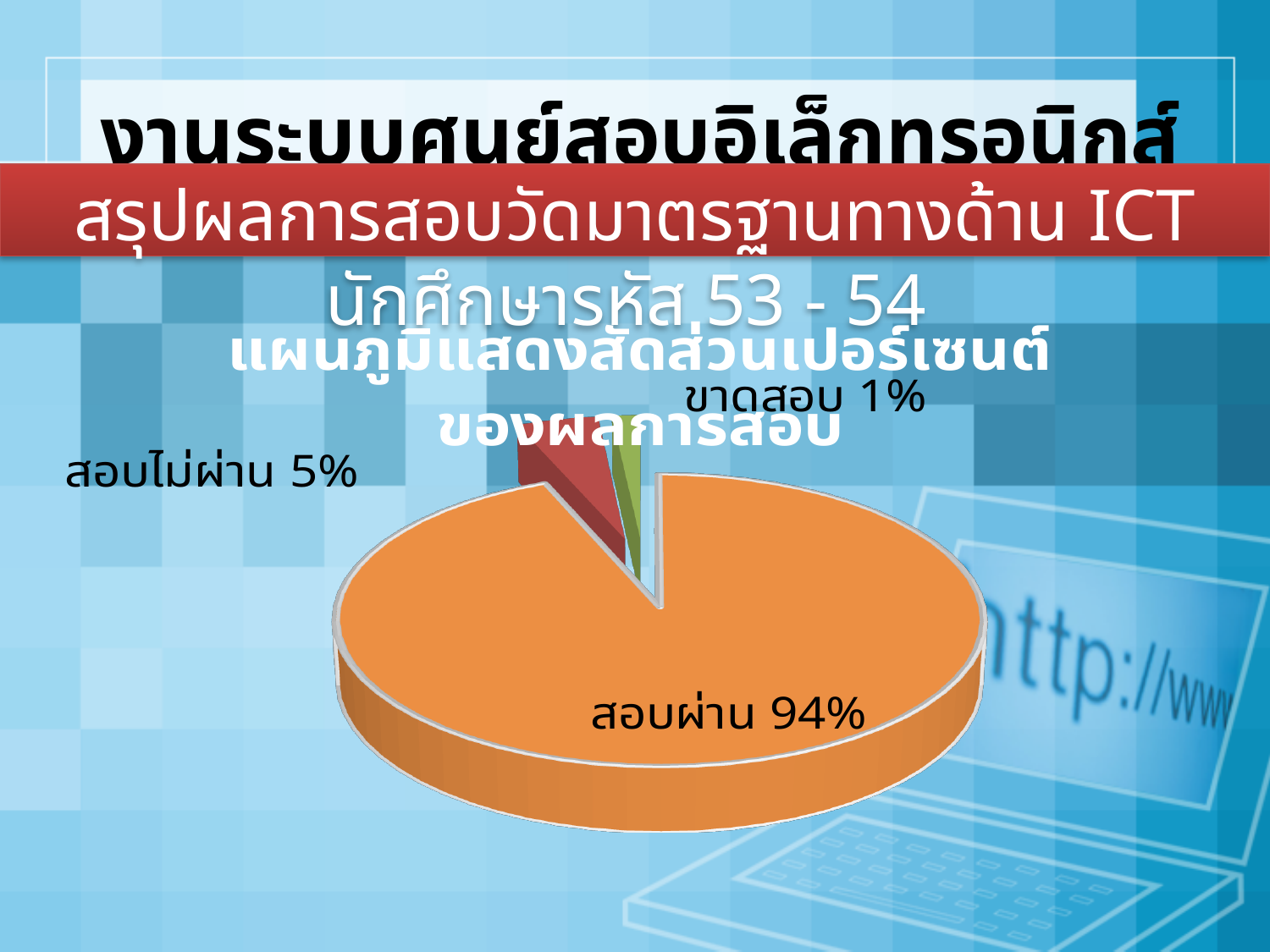
What kind of chart is shown on the slide? pie chart What is the difference in percentage points between สอบไม่ผ่าน and ขาดสอบ? 4 What colour is the สอบไม่ผ่าน slice of the pie chart? red How many slices does the pie chart have? 3 What is the difference in percentage points between สอบผ่าน and สอบไม่ผ่าน? 89 What percentage of the pie is labelled ขาดสอบ? 1% What percentage of the pie is labelled สอบผ่าน? 94% What percentage of the pie is labelled สอบไม่ผ่าน? 5% What colour is the สอบผ่าน slice of the pie chart? orange Which slice of the pie chart is the largest? สอบผ่าน Which is larger, the share for สอบไม่ผ่าน or the share for ขาดสอบ? สอบไม่ผ่าน Which slice of the pie chart is the smallest? ขาดสอบ